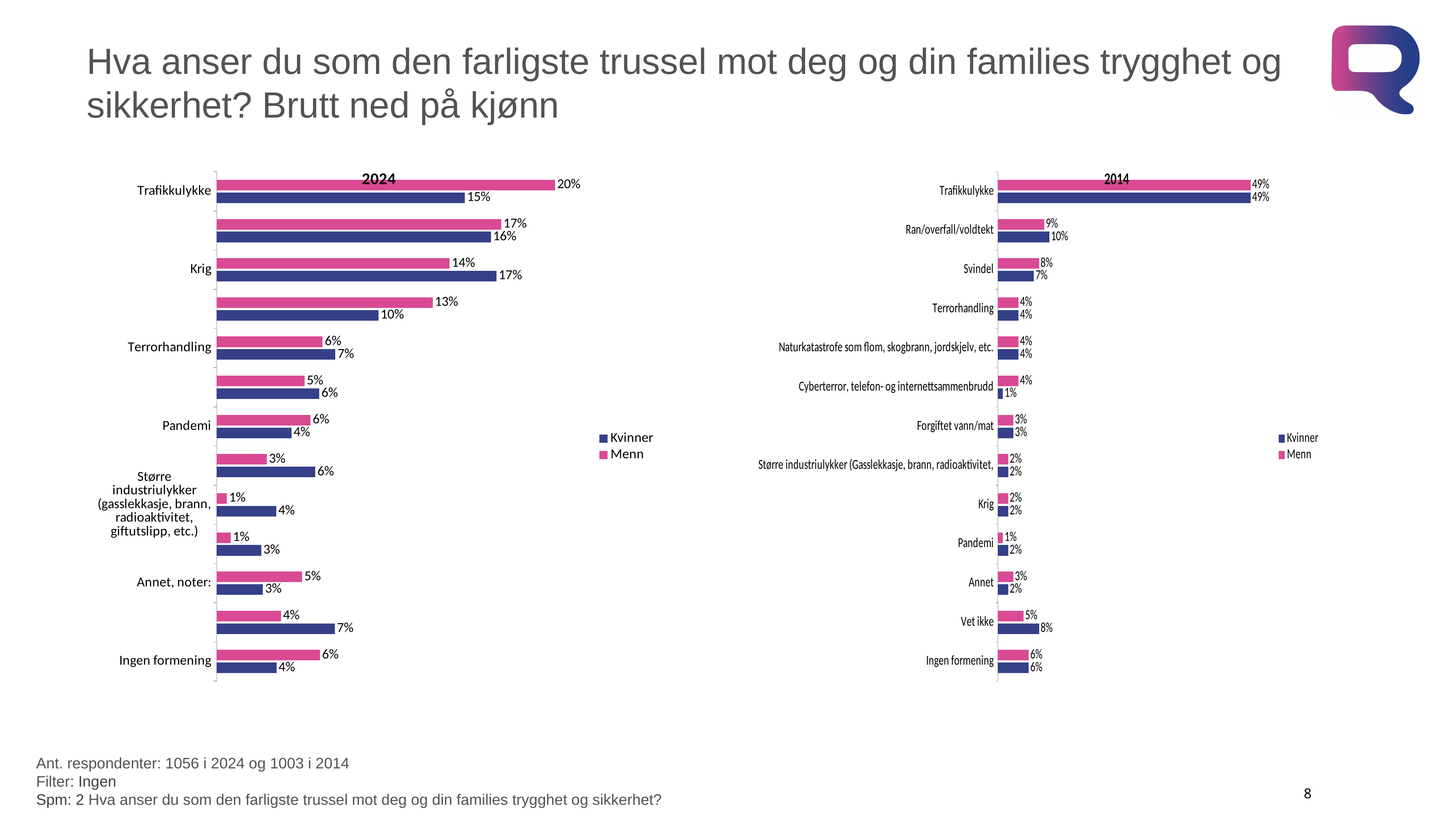
In the 2014 chart, what is the value for Kvinner for Trafikkulykke? 49% In the 2024 chart, what is the difference between Menn and Kvinner for Trafikkulykke? 5% In the 2024 chart, which is larger for Pandemi, Kvinner or Menn? Menn What type of chart is the 2014 chart? Bar chart In the 2014 chart, which category has the highest value for Menn? Trafikkulykke In the 2024 chart, what is the value for Menn for Trafikkulykke? 20% In the 2024 chart, what is the value for Kvinner for Ingen formening? 4% In the 2014 chart, what is the value for Kvinner for Vet ikke? 8% How many categories are shown in the 2014 chart? 13 In the 2024 chart, what is the value for Kvinner for Krig? 17% In the 2014 chart, what is the difference between Menn and Kvinner for Cyberterror, telefon- og internettsammenbrudd? 3% How many series does the legend of the 2024 chart list? 2